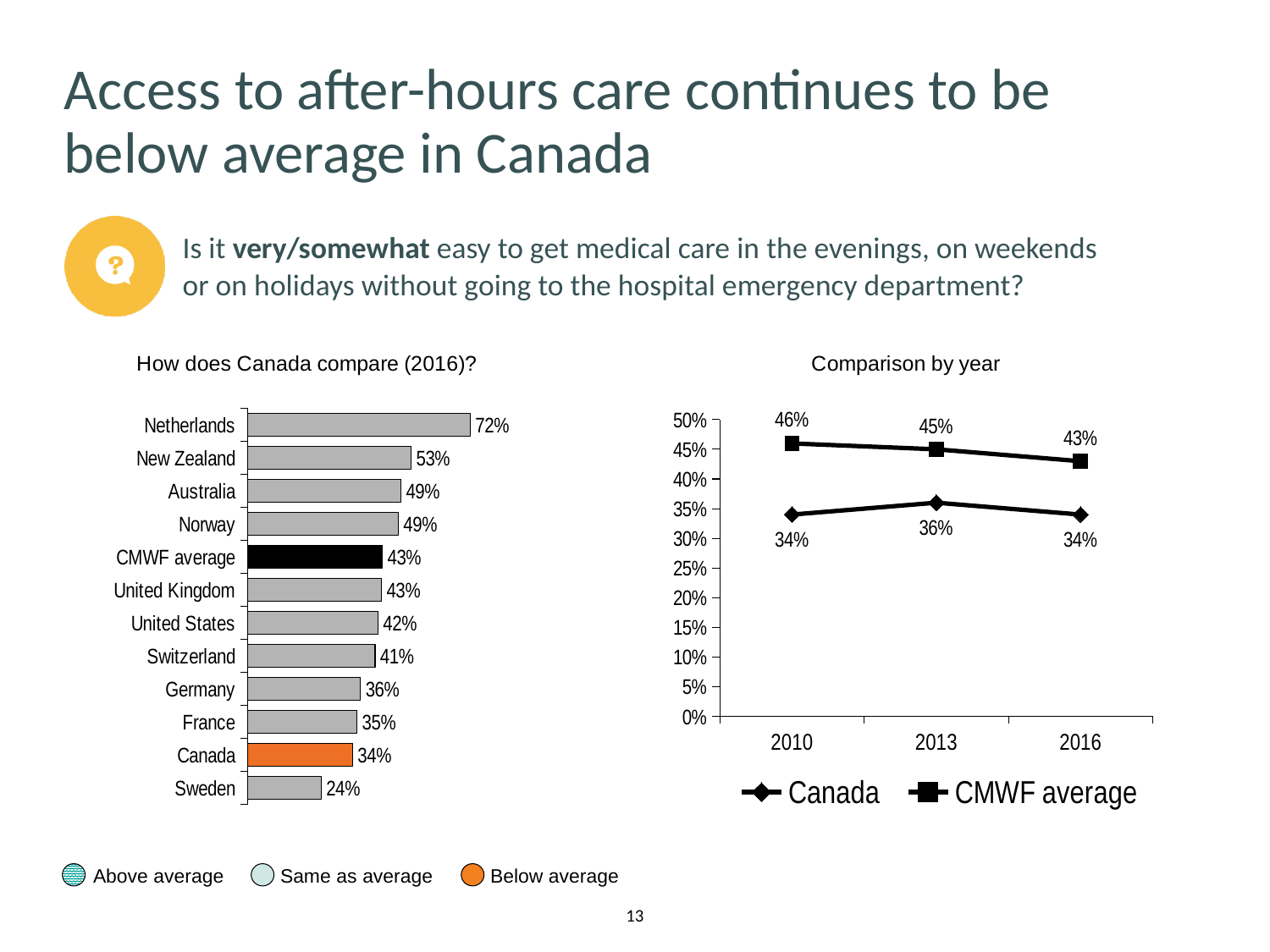
In the 'Comparison by year' chart, what is the CMWF average value for 2010? 46% In the 'How does Canada compare (2016)?' chart, what kind of chart is it? Bar chart In the 'Comparison by year' chart, does the CMWF average rise or fall from 2010 to 2016? Fall In the 'How does Canada compare (2016)?' chart, which country has the lowest value? Sweden In the 'How does Canada compare (2016)?' chart, how many bars are shown? 12 In the 'Comparison by year' chart, how many series does the legend list? 2 In the 'How does Canada compare (2016)?' chart, what is the value for Canada? 34% In the 'Comparison by year' chart, what is the value for Canada in 2013? 36% In the 'How does Canada compare (2016)?' chart, what is the value for the Netherlands? 72% In the 'How does Canada compare (2016)?' chart, which country has the highest value? Netherlands In the 'How does Canada compare (2016)?' chart, what is the difference between the CMWF average and Canada? 9% In the 'Comparison by year' chart, which is larger in 2016, Canada or the CMWF average? CMWF average